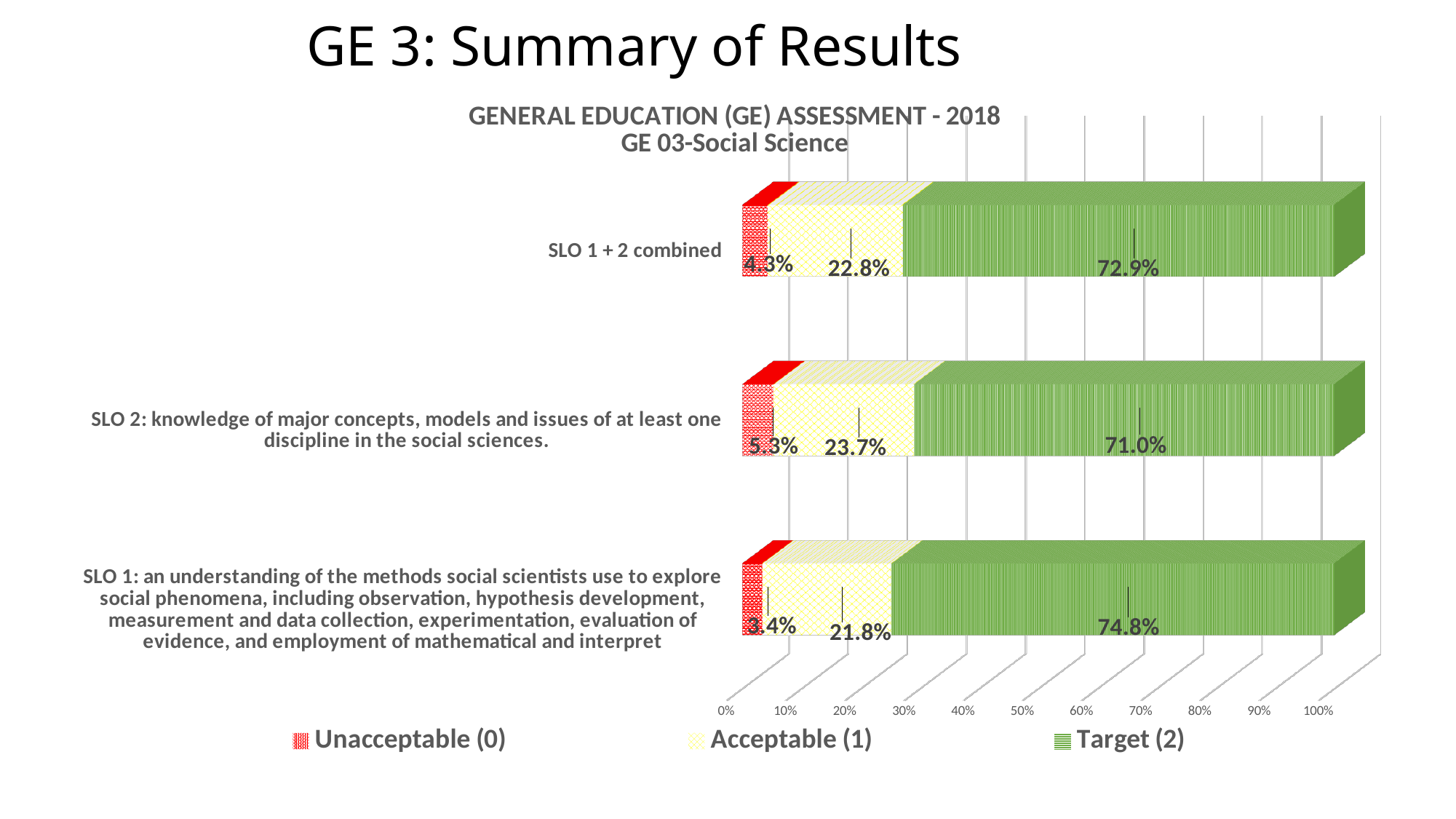
Which category has the highest Target (2) value? SLO 1 What is the difference between the Target (2) values for SLO 1 and SLO 2? 3.8% What kind of chart is shown on the slide? Stacked bar chart Which legend entry is shown in green? Target (2) How many series does the legend list? 3 How many categories (bars) does the chart show? 3 Which category has the lowest Unacceptable (0) value? SLO 1 What is the Acceptable (1) value for SLO 1? 21.8% Is the Acceptable (1) value larger for SLO 2 or for SLO 1 + 2 combined? SLO 2 What is the Unacceptable (0) value for SLO 2? 5.3% What is the total of the stacked bar for SLO 2? 100.0% What is the Target (2) value for SLO 1 + 2 combined? 72.9%